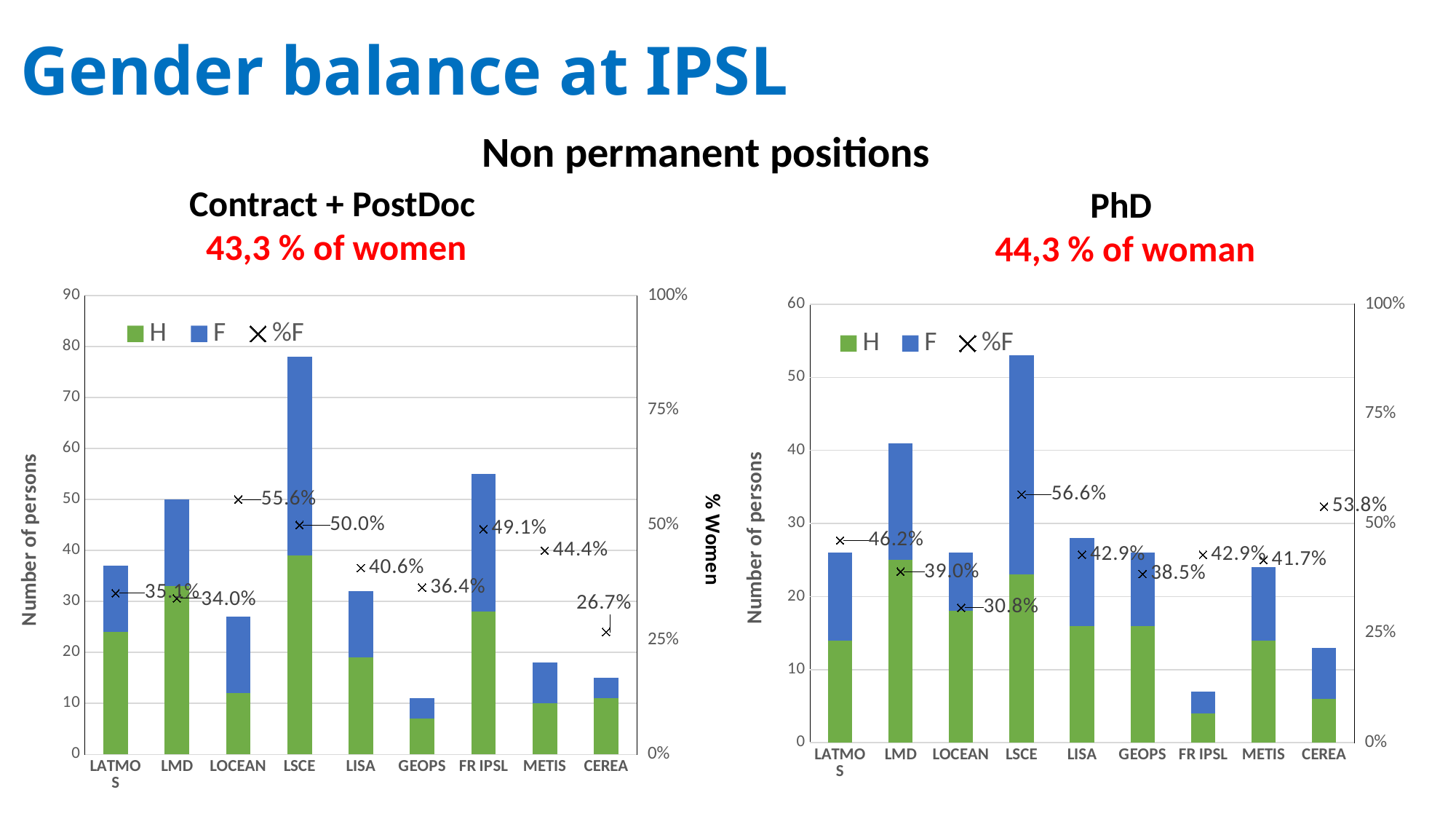
In the PhD chart, what is the difference in percentage points between the %F of LSCE and the %F of LOCEAN? 25.8 In the Contract + PostDoc chart, which laboratory has the highest %F? LOCEAN How many series does the legend of the Contract + PostDoc chart list? 3 In the Contract + PostDoc chart, which laboratory has the lowest %F? CEREA In the PhD chart, what is the %F value for LSCE? 56.6% In the PhD chart, is the total number of persons for FR IPSL greater or less than 10? less How many laboratories are shown on the x axis of the PhD chart? 9 In the Contract + PostDoc chart, what is the %F value for LOCEAN? 55.6% In the Contract + PostDoc chart, is the %F for FR IPSL larger or smaller than the %F for METIS? larger In the Contract + PostDoc chart, is the total number of persons for LSCE greater or less than 70? greater In the PhD chart, what is the %F value for CEREA? 53.8% In the PhD chart, which laboratory has the lowest %F? LOCEAN